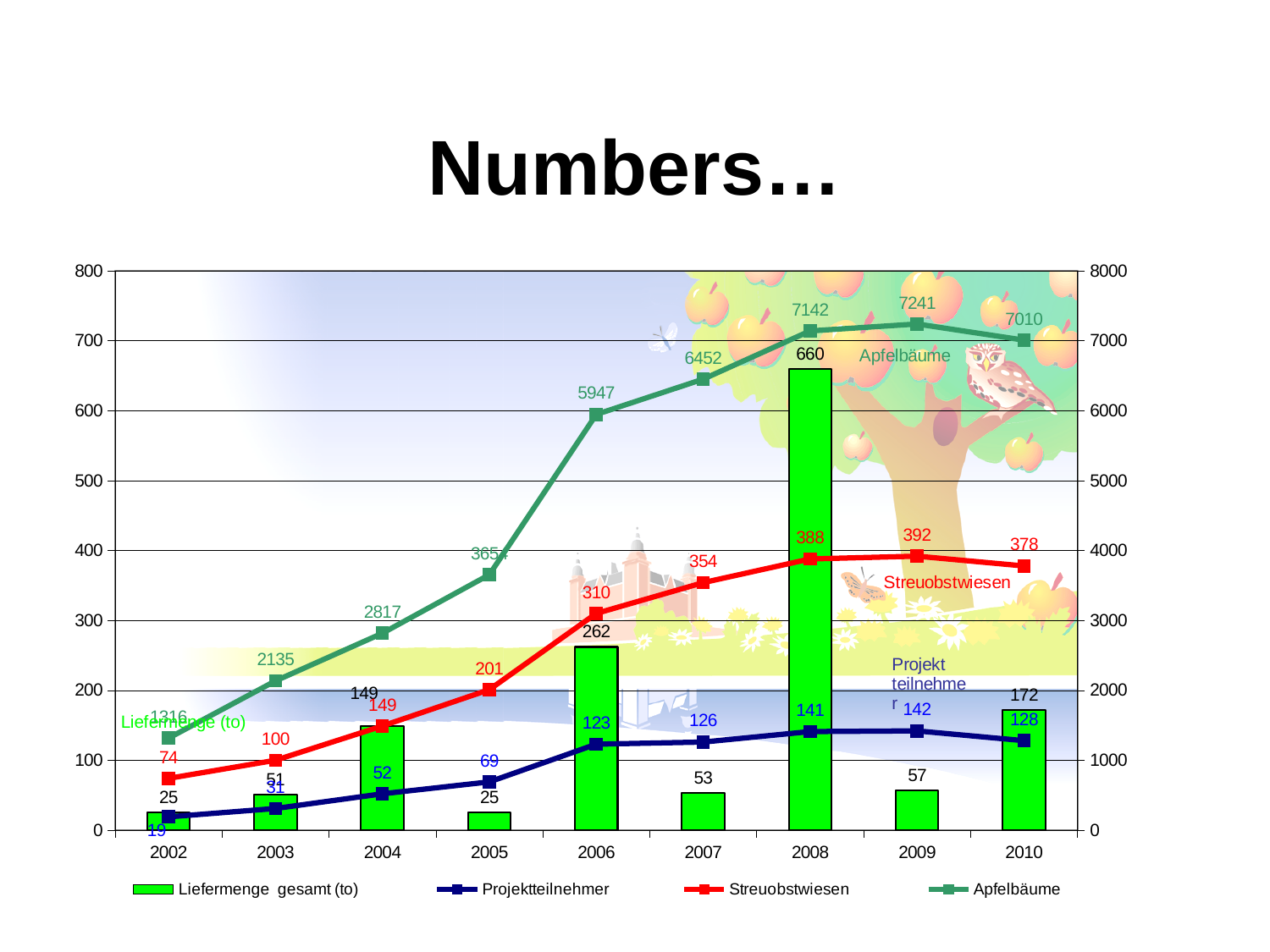
In which year is Liefermenge gesamt (to) highest? 2008 In which year does the Apfelbäume series reach its highest value? 2009 What is the value of Liefermenge gesamt (to) in 2008? 660 In which year is the Projektteilnehmer value lowest? 2002 What kind of chart is shown on the slide? Combination bar and line chart What is the Apfelbäume value in 2009? 7241 What is the difference between Liefermenge gesamt (to) in 2008 and in 2006? 398 Which year has the larger Projektteilnehmer value, 2008 or 2010? 2008 How many series does the legend list? 4 What is the Streuobstwiesen value in 2007? 354 How many years are shown on the x axis? 9 Does the Apfelbäume series rise or fall from 2002 to 2009? Rise